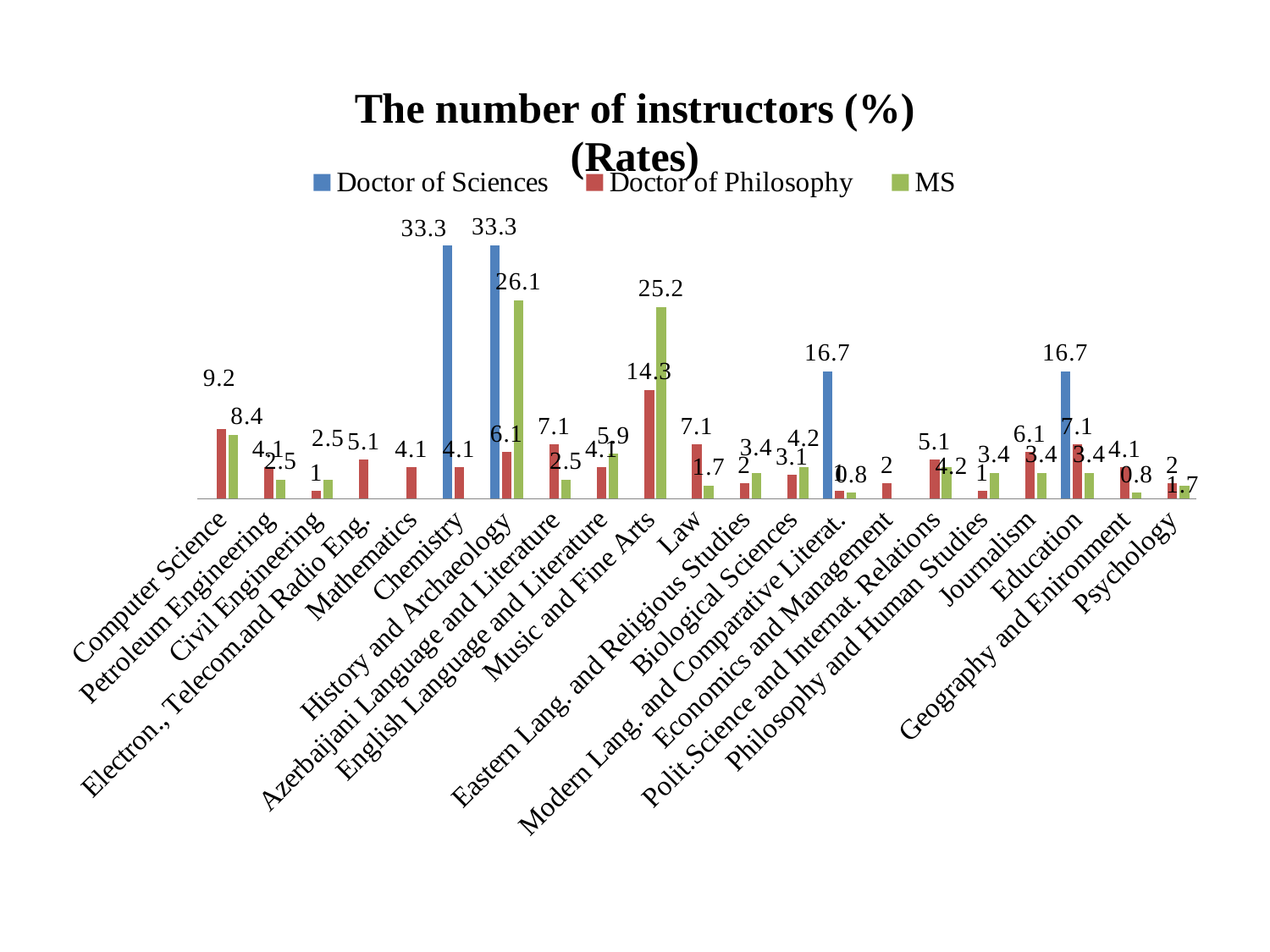
What is the Doctor of Philosophy value for Music and Fine Arts? 14.3 How many series does the legend list? 3 What is the difference between the Doctor of Philosophy value for Computer Science and the Doctor of Philosophy value for Law? 2.1 What type of chart is shown on the slide? bar chart What is the MS value for History and Archaeology? 26.1 What is the difference between the MS value for Music and Fine Arts and the MS value for History and Archaeology? 0.9 What is the Doctor of Sciences value for Chemistry? 33.3 Which is larger for Music and Fine Arts: the Doctor of Philosophy value or the MS value? MS What is the MS value for Computer Science? 8.4 Which category has the highest MS value? History and Archaeology What is the Doctor of Sciences value for Education? 16.7 Which series is shown in blue in the legend? Doctor of Sciences